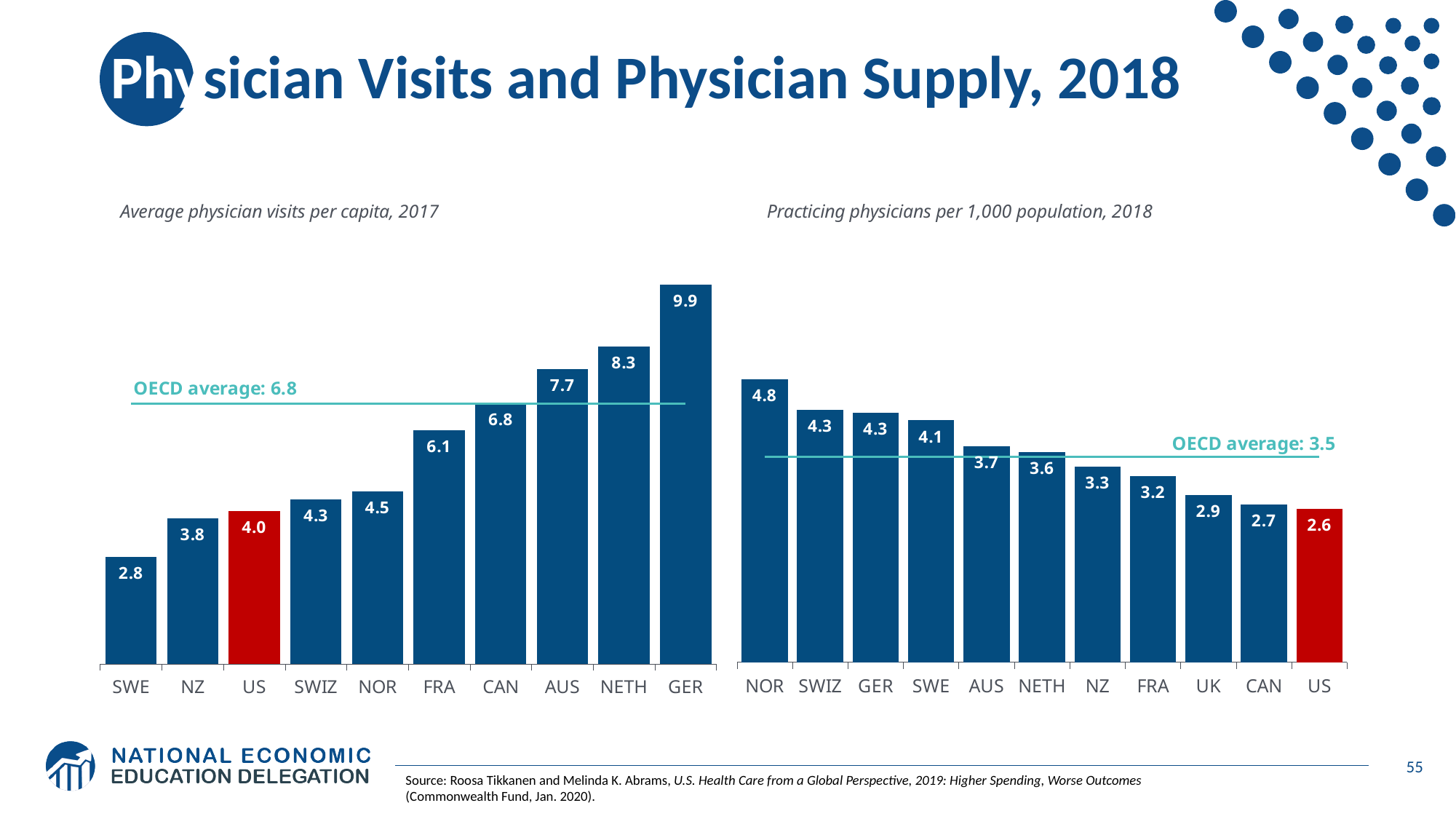
In the 'Average physician visits per capita, 2017' chart, what is the difference between GER and SWE? 7.1 In the 'Practicing physicians per 1,000 population, 2018' chart, which country has the lowest value? US In the 'Practicing physicians per 1,000 population, 2018' chart, what is the difference between NOR and US? 2.2 In the 'Average physician visits per capita, 2017' chart, which country has the highest value? GER In the 'Practicing physicians per 1,000 population, 2018' chart, which is larger, the value for UK or the value for CAN? UK In the 'Average physician visits per capita, 2017' chart, what is the value for the US? 4.0 What kind of chart is the 'Average physician visits per capita, 2017' chart? Bar chart In the 'Practicing physicians per 1,000 population, 2018' chart, what is the value for NOR? 4.8 What OECD average is marked on the 'Practicing physicians per 1,000 population, 2018' chart? 3.5 In the 'Practicing physicians per 1,000 population, 2018' chart, how many countries are shown? 11 In the 'Average physician visits per capita, 2017' chart, how many countries are shown? 10 In the 'Average physician visits per capita, 2017' chart, which country has the lowest value? SWE